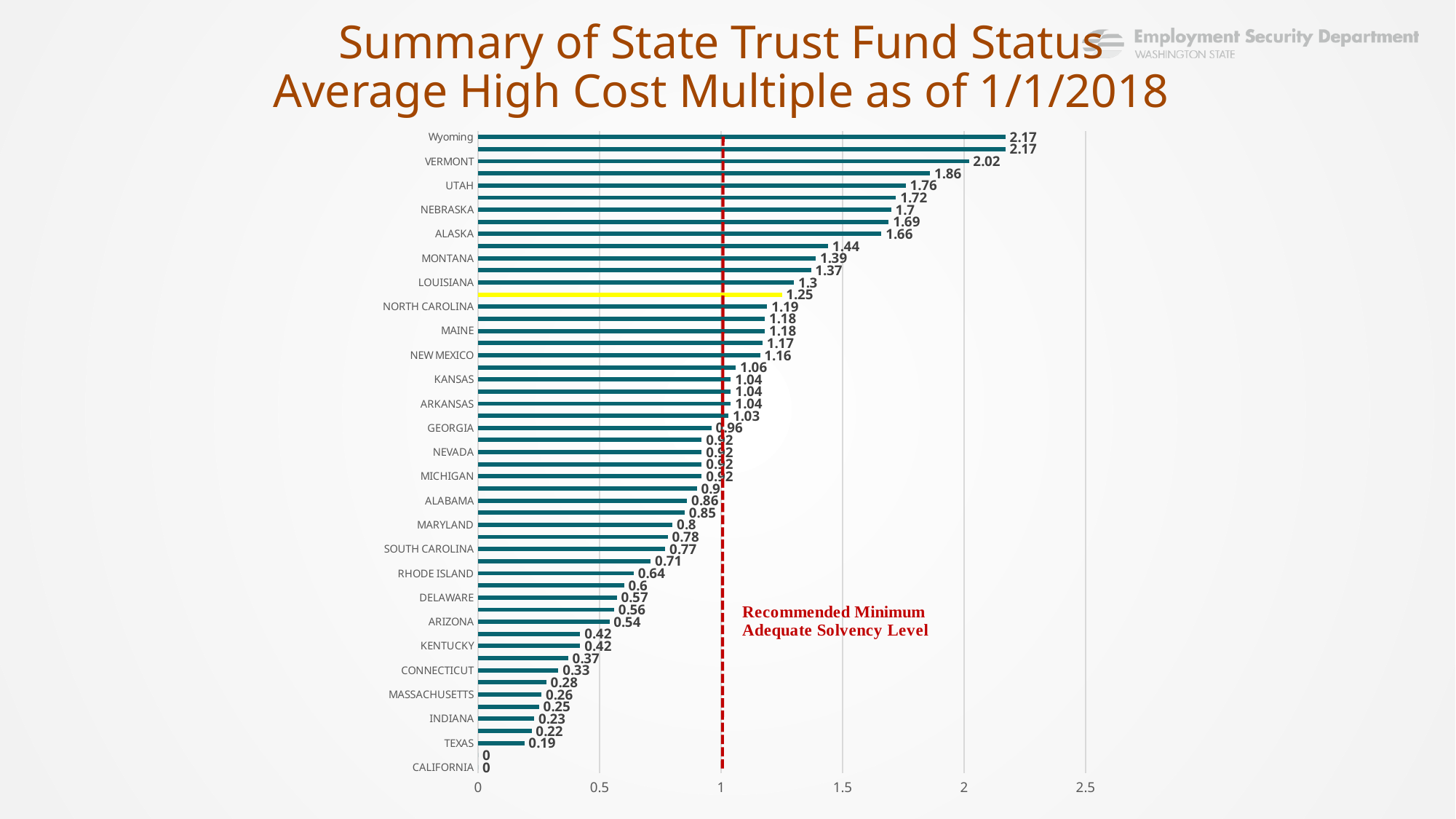
What is the average high cost multiple for Vermont? 2.02 Is the value for Louisiana greater or less than 1? greater What is the value shown for Texas? 0.19 Do the values increase or decrease going from the top of the chart to the bottom? Decrease Which has a higher value, Nebraska or Alaska? Nebraska What is the value shown for California? 0 What is the value shown for Utah? 1.76 What does the red dashed vertical line at 1 represent? Recommended Minimum Adequate Solvency Level What is the value shown for Georgia? 0.96 What is the difference between the values for Vermont and Utah? 0.26 What kind of chart is shown on the slide? Bar chart What is the value shown for Montana? 1.39